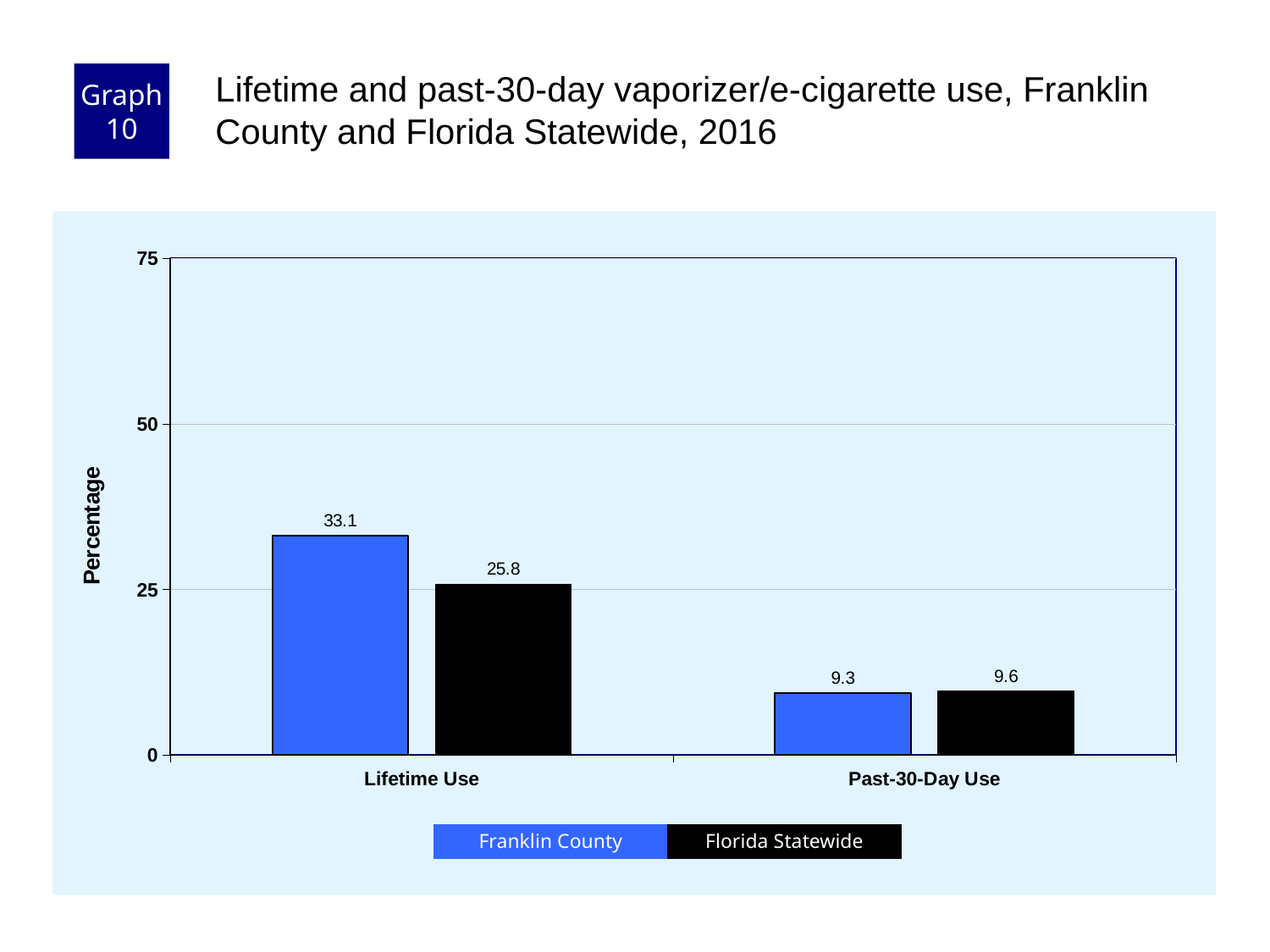
What is the difference between the Franklin County and Florida Statewide values for Lifetime Use? 7.3 For Lifetime Use, which is larger: Franklin County or Florida Statewide? Franklin County Which bar has the lowest value on the chart? Franklin County, Past-30-Day Use How many series does the legend list? 2 What is the Franklin County value for Past-30-Day Use? 9.3 What is the Florida Statewide value for Past-30-Day Use? 9.6 What is the Florida Statewide value for Lifetime Use? 25.8 Is the Franklin County value for Lifetime Use greater or less than 25? greater What kind of chart is shown on the slide? bar chart Which bar has the highest value on the chart? Franklin County, Lifetime Use How many categories are shown on the x axis? 2 What is the Franklin County value for Lifetime Use? 33.1